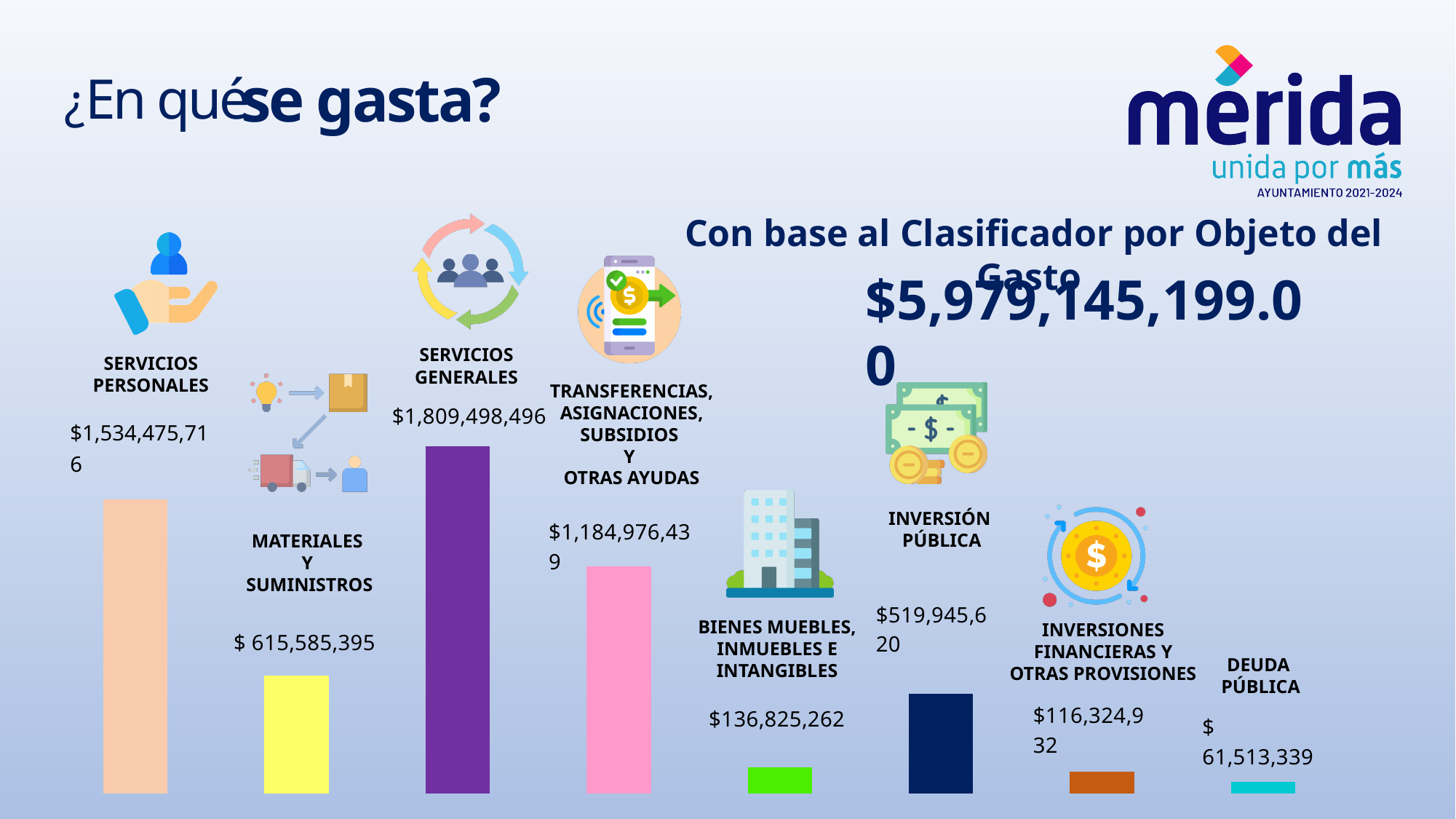
Which category has the lowest value? DEUDA PÚBLICA What is the value shown for MATERIALES Y SUMINISTROS? $ 615,585,395 What is the value shown for INVERSIÓN PÚBLICA? $519,945,620 Which category has the highest value? SERVICIOS GENERALES What is the value shown for DEUDA PÚBLICA? $ 61,513,339 What is the value shown for SERVICIOS GENERALES? $1,809,498,496 What total amount is shown on the slide for the expenditure? $5,979,145,199.00 What kind of chart is shown on the slide? Bar chart Which is larger, the value for TRANSFERENCIAS, ASIGNACIONES, SUBSIDIOS Y OTRAS AYUDAS or the value for MATERIALES Y SUMINISTROS? TRANSFERENCIAS, ASIGNACIONES, SUBSIDIOS Y OTRAS AYUDAS How many categories are shown in the chart? 8 What is the difference between the values for BIENES MUEBLES, INMUEBLES E INTANGIBLES and INVERSIONES FINANCIERAS Y OTRAS PROVISIONES? $20,500,330 What is the difference between the values for SERVICIOS GENERALES and SERVICIOS PERSONALES? $275,022,780